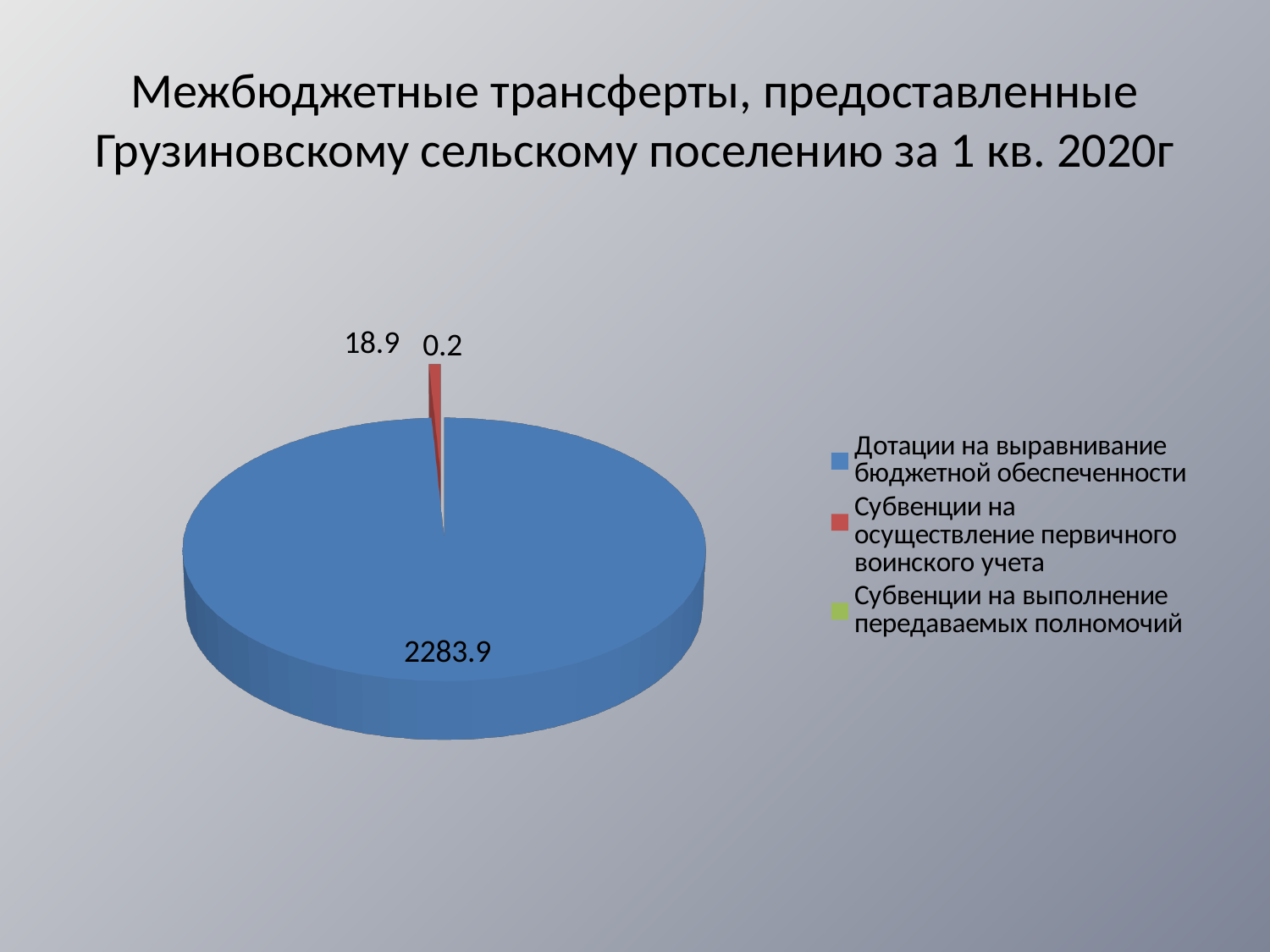
Which category has the smallest value? Субвенции на выполнение передаваемых полномочий What colour is the slice for Субвенции на осуществление первичного воинского учета? Red What is the difference between the values for Субвенции на осуществление первичного воинского учета and Субвенции на выполнение передаваемых полномочий? 18.7 How many categories does the pie chart show? 3 What is the value for Дотации на выравнивание бюджетной обеспеченности? 2283.9 Which category has the largest value? Дотации на выравнивание бюджетной обеспеченности What type of chart is shown on the slide? Pie chart What is the value for Субвенции на осуществление первичного воинского учета? 18.9 What is the difference between the values for Дотации на выравнивание бюджетной обеспеченности and Субвенции на осуществление первичного воинского учета? 2265.0 Which is larger: Субвенции на осуществление первичного воинского учета or Субвенции на выполнение передаваемых полномочий? Субвенции на осуществление первичного воинского учета What is the total of all the values shown in the pie chart? 2303.0 What is the value for Субвенции на выполнение передаваемых полномочий? 0.2